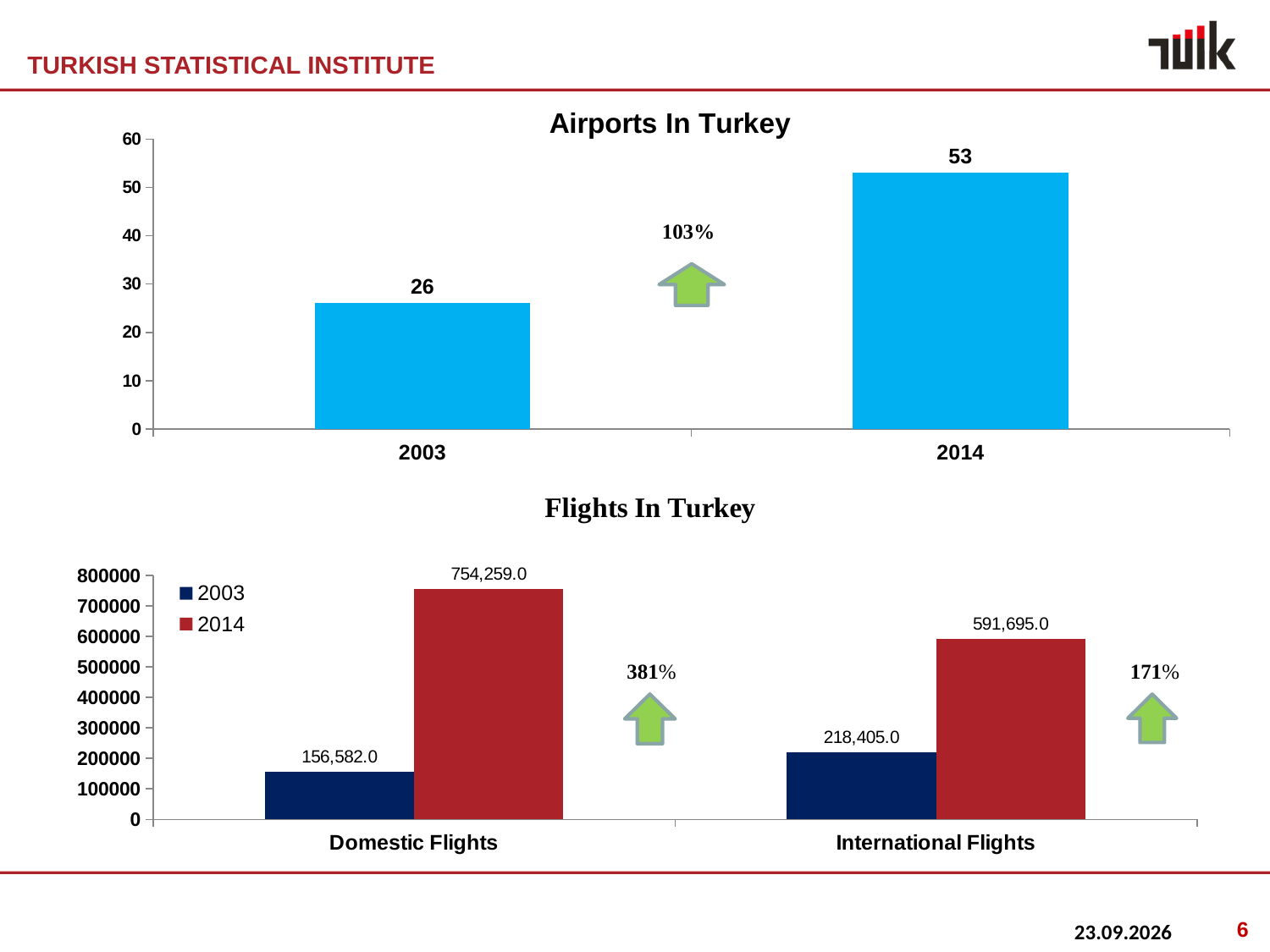
In the 'Airports In Turkey' chart, what is the difference between the 2014 and 2003 values? 27 In the 'Flights In Turkey' chart, what is the value for International Flights in 2003? 218,405.0 In the 'Airports In Turkey' chart, how many airports were there in 2014? 53 In the 'Flights In Turkey' chart, what is the difference between the 2014 and 2003 values for International Flights? 373,290.0 What type of chart is the 'Airports In Turkey' chart? bar chart In the 'Flights In Turkey' chart, which is larger: International Flights in 2003 or Domestic Flights in 2003? International Flights in 2003 In the 'Flights In Turkey' chart, how many series does the legend list? 2 In the 'Flights In Turkey' chart, what is the value for Domestic Flights in 2003? 156,582.0 In the 'Airports In Turkey' chart, how many airports were there in 2003? 26 In the 'Airports In Turkey' chart, what percentage increase is shown next to the arrow? 103% In the 'Flights In Turkey' chart, what is the value for Domestic Flights in 2014? 754,259.0 In the 'Flights In Turkey' chart, which category has the highest 2014 value? Domestic Flights